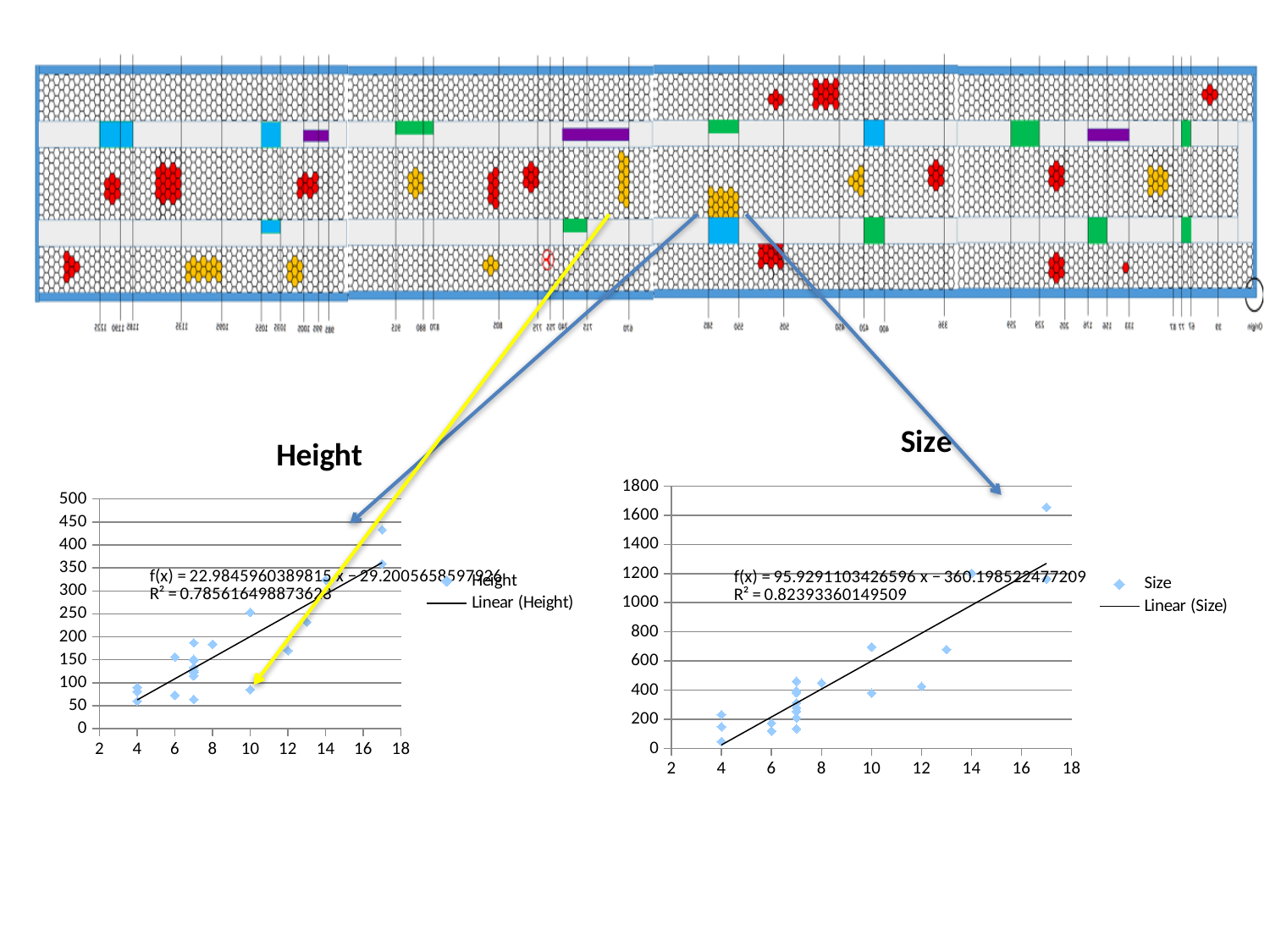
What R² value is printed on the Height chart? 0.785616498873628 On the Size chart, at which x value does the highest plotted point occur? 17 How many series does the legend of the Size chart list? 2 What R² value is printed on the Size chart? 0.82393360149509 On the Height chart, do the plotted values generally rise or fall as x increases? rise On the Size chart, do the plotted values generally rise or fall as x increases? rise On the Size chart, is the value of the highest point at x = 17 greater or less than 1400? greater What kind of chart is the Height chart? scatter chart On the Size chart, is the value of the point at x = 12 greater or less than 600? less What are the two legend entries on the Height chart? Height and Linear (Height) Which chart shows the higher R² value, Height or Size? Size